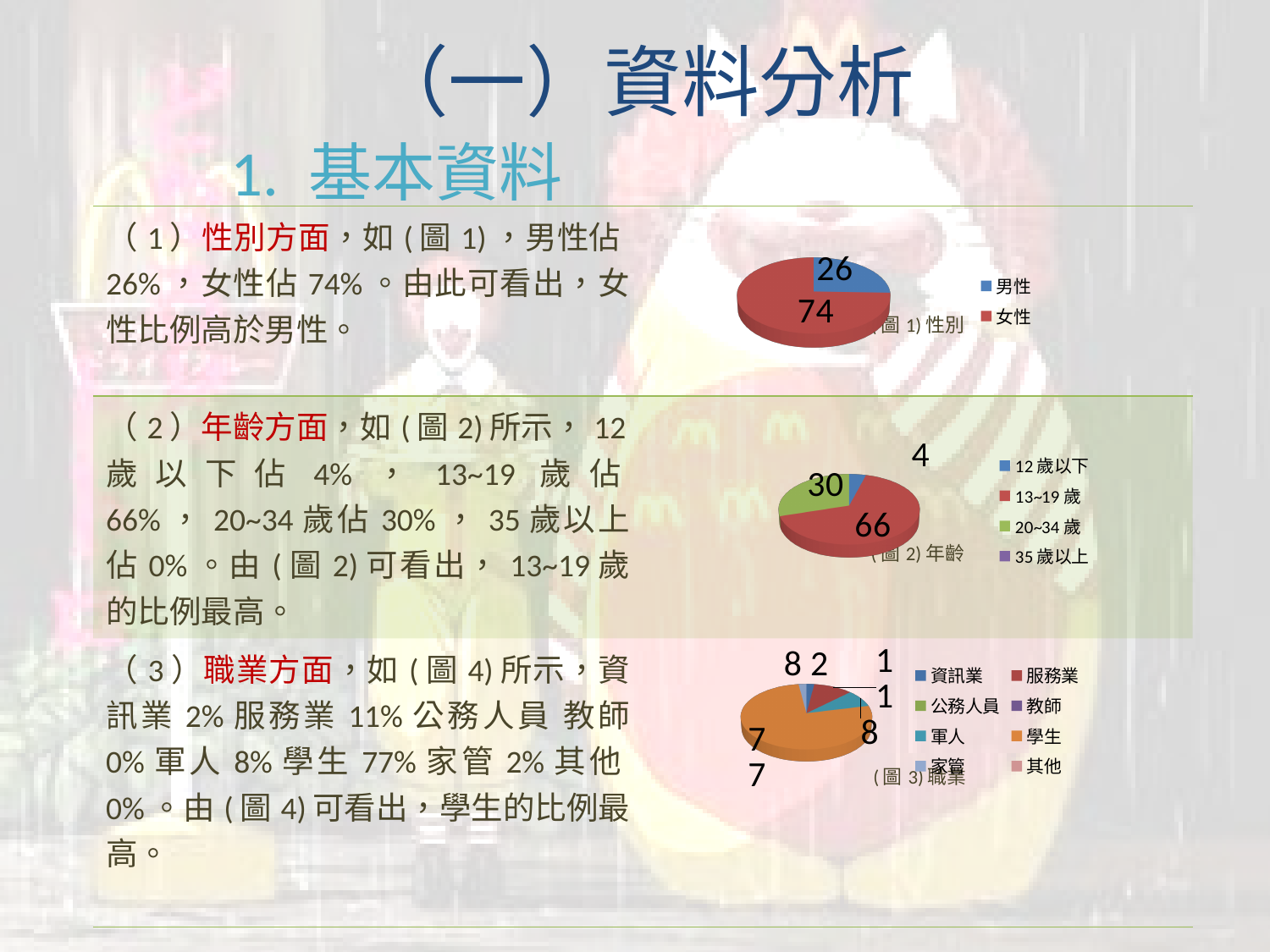
In the chart titled (圖 1) 性別, what value is shown for 男性? 26 In the chart titled (圖 1) 性別, what value is shown for 女性? 74 In the chart titled (圖 2) 年齡, what value is shown for 20~34 歲? 30 In the chart titled (圖 1) 性別, what is the difference between the values for 女性 and 男性? 48 What kind of chart is the one titled (圖 1) 性別? Pie chart In the chart titled (圖 3) 職業, which category has the largest slice? 學生 How many categories does the legend of the chart titled (圖 3) 職業 list? 8 In the chart titled (圖 2) 年齡, what value is shown for 12 歲以下? 4 In the chart titled (圖 2) 年齡, what value is shown for 13~19 歲? 66 In the chart titled (圖 2) 年齡, which category has the largest slice? 13~19 歲 In the chart titled (圖 1) 性別, which category has the larger slice? 女性 How many categories does the legend of the chart titled (圖 2) 年齡 list? 4